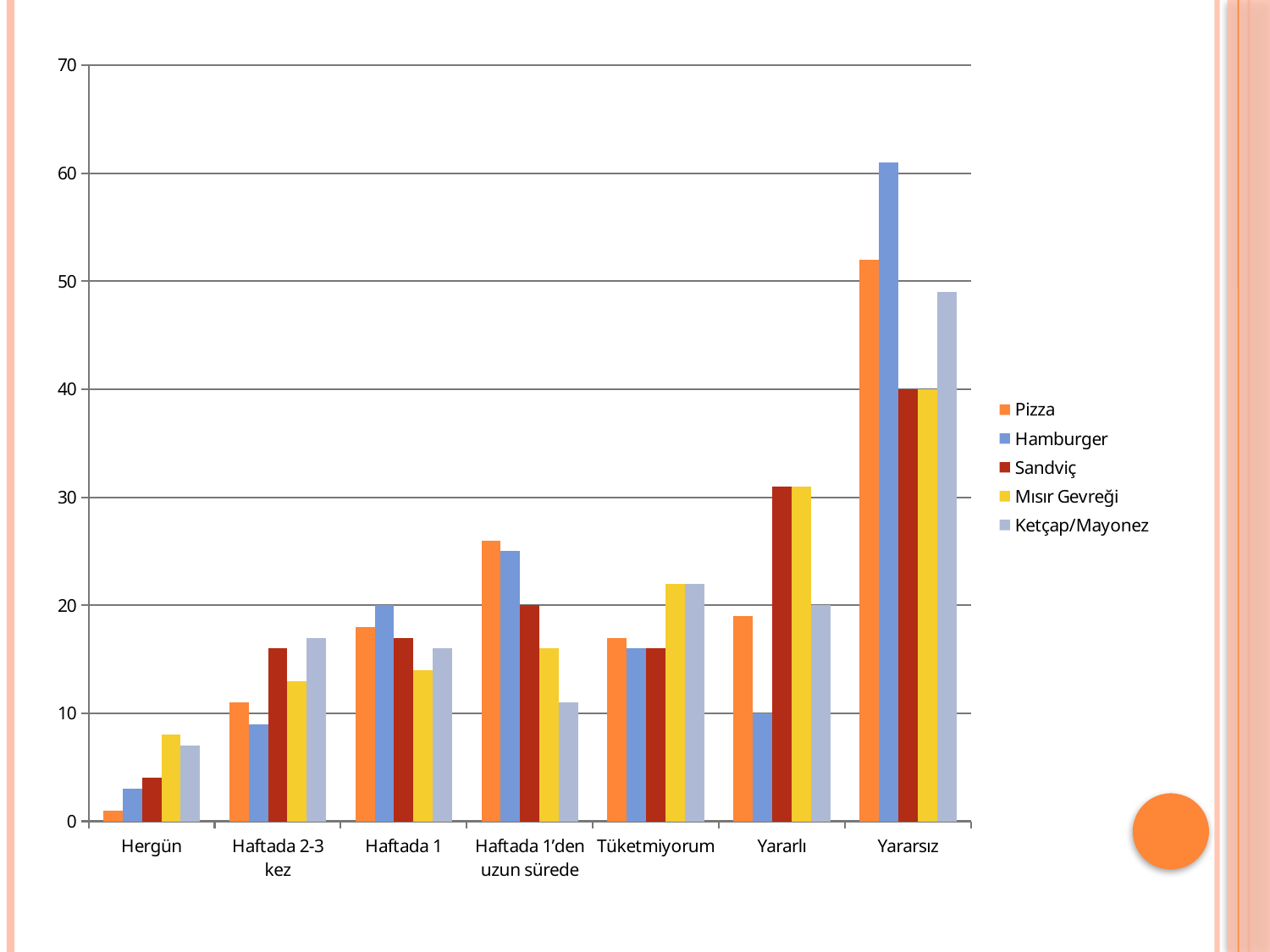
In the Yararlı category, which is larger: Pizza or Sandviç? Sandviç What kind of chart is shown on the slide? bar chart What is the value for Hamburger in the Haftada 1 category? 20 What is the value for Sandviç in the Yararsız category? 40 Which series is shown in yellow in the legend? Mısır Gevreği What is the value for Hamburger in the Yararlı category? 10 Which series has the lowest bar in the Hergün category? Pizza Is the value for Hamburger in the Yararsız category greater or less than 60? greater How many series does the legend list? 5 What is the value for Ketçap/Mayonez in the Yararlı category? 20 Which series has the highest bar in the Yararsız category? Hamburger How many categories are shown on the x axis? 7